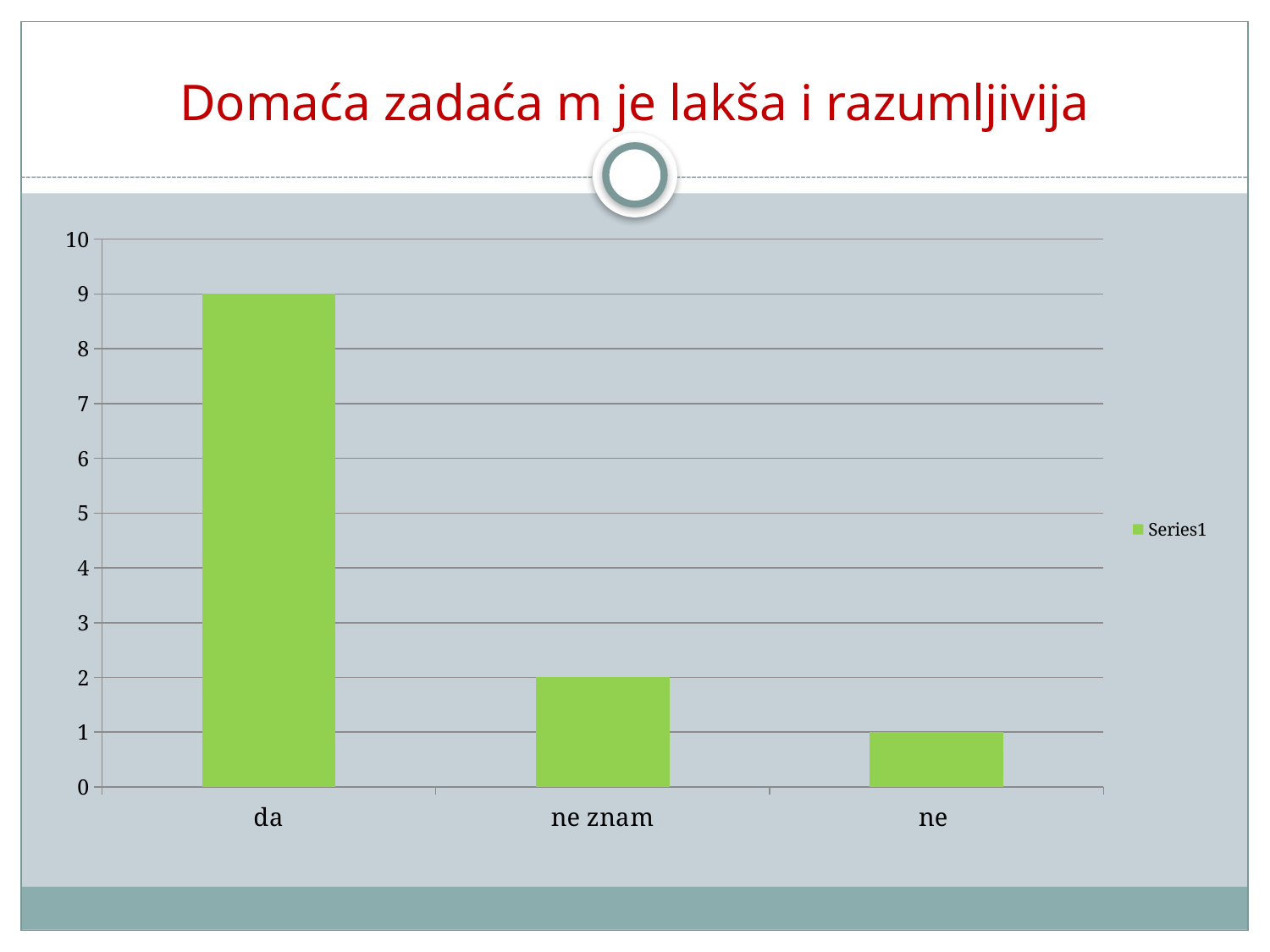
What is the difference between the values for "da" and "ne znam"? 7 Which category has the highest value? da Which category has the lowest value? ne What is the difference between the values for "ne znam" and "ne"? 1 Which is larger, the value for "ne znam" or the value for "ne"? ne znam Is the value for "da" greater or less than 5? greater How many categories are shown on the x axis? 3 What kind of chart is shown on the slide? bar chart What is the title of the slide? Domaća zadaća m je lakša i razumljivija What is the value for "ne znam"? 2 What is the value for "da"? 9 What is the value for "ne"? 1